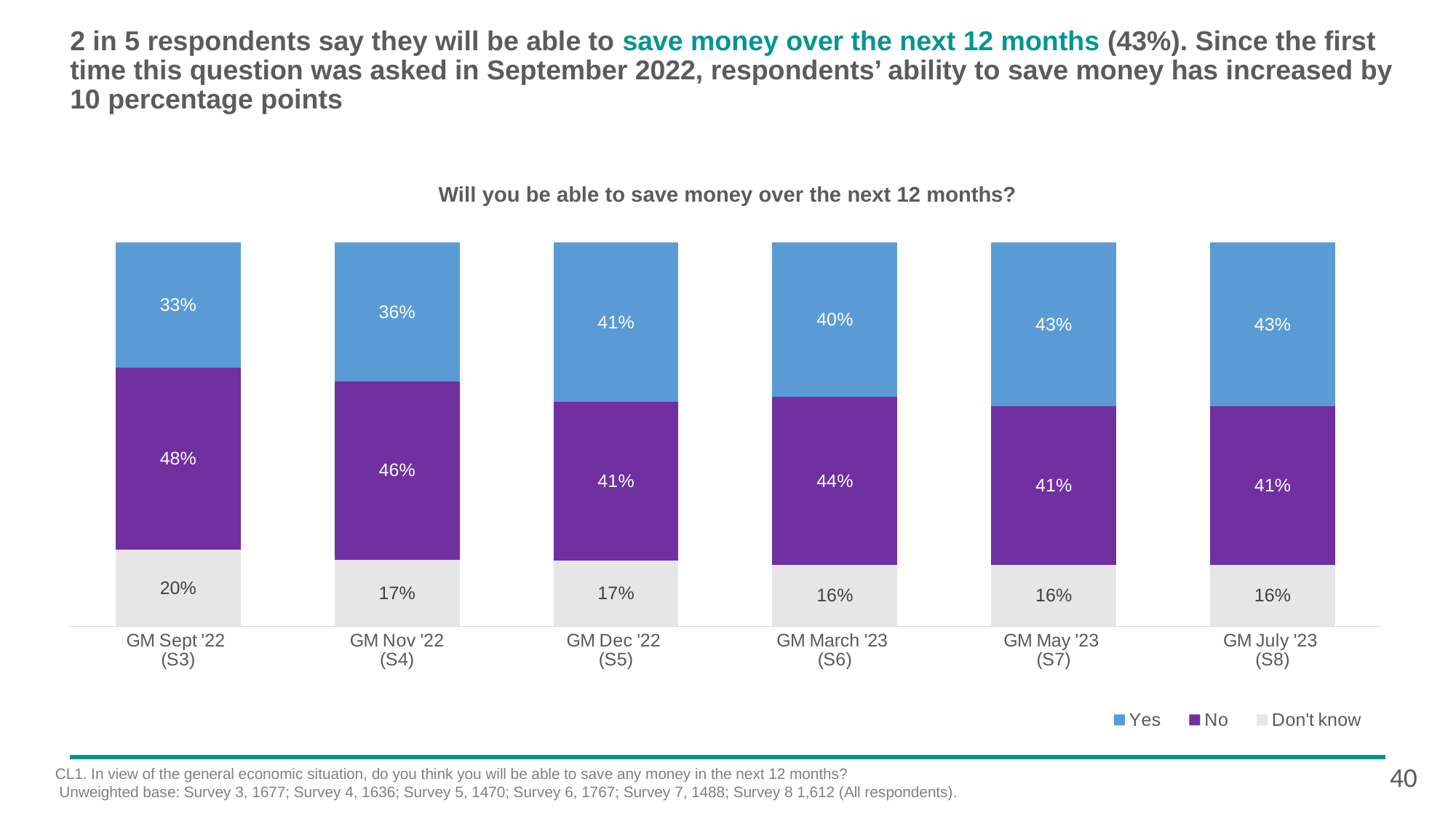
Which is larger in GM Nov '22 (S4): the 'Yes' share or the 'No' share? No What percentage of respondents answered 'Yes' in GM Sept '22 (S3)? 33% What percentage of respondents answered 'No' in GM March '23 (S6)? 44% How many survey waves are shown on the x axis? 6 What is the difference in percentage points between the 'Yes' share in GM July '23 (S8) and GM Sept '22 (S3)? 10 How many series does the legend list? 3 What percentage of respondents answered 'Don't know' in GM July '23 (S8)? 16% What kind of chart is shown on the slide? Stacked bar chart Does the 'Don't know' share rise or fall from GM Sept '22 (S3) to GM July '23 (S8)? Fall In which survey wave was the 'Yes' share lowest? GM Sept '22 (S3) What is the title of the chart? Will you be able to save money over the next 12 months? In which survey wave was the 'No' share highest? GM Sept '22 (S3)